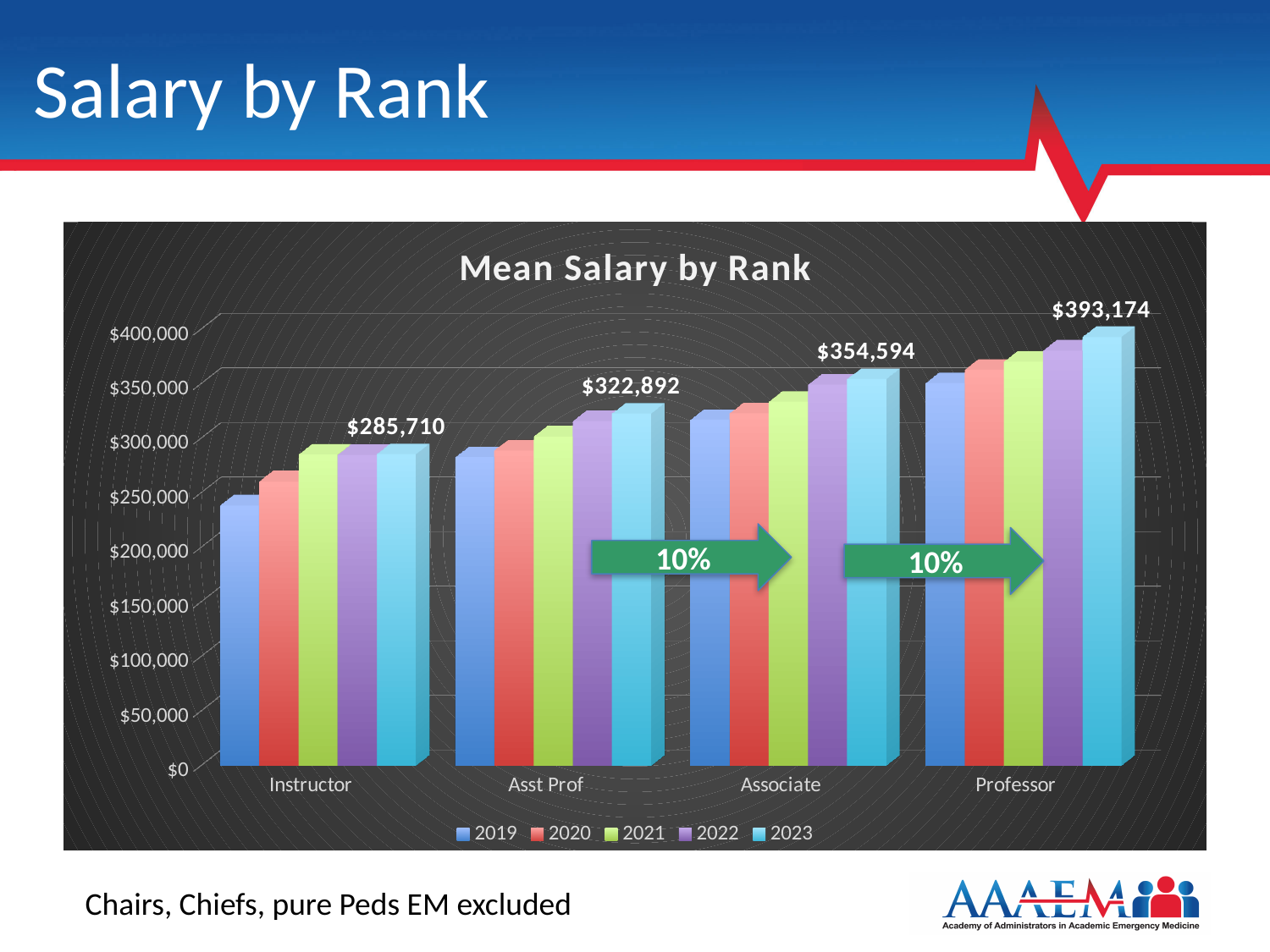
What is the data label shown for the Instructor rank? $285,710 Which rank has the lowest labelled mean salary? Instructor How many rank categories are shown on the x axis of the chart? 4 How many series does the chart's legend list? 5 What is the data label shown for the Professor rank? $393,174 What type of chart is shown on the slide? Bar chart What is the data label shown for the Asst Prof rank? $322,892 Which rank has the highest labelled mean salary? Professor What is the title of the chart? Mean Salary by Rank What is the difference between the labelled values for Professor and Associate? $38,580 What is the data label shown for the Associate rank? $354,594 Is the 2019 value for Asst Prof greater or less than $300,000? less